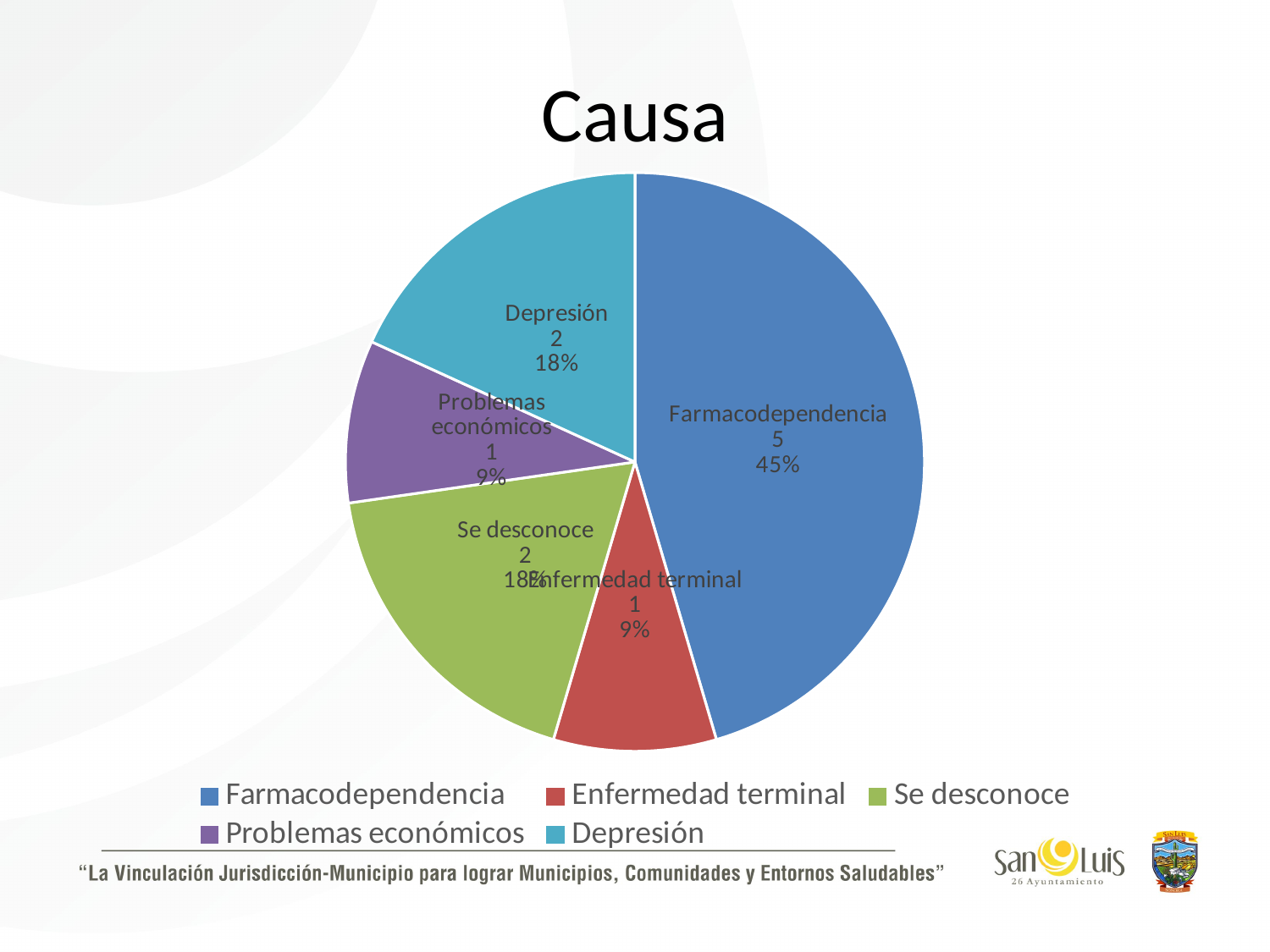
How many slices does the pie chart have? 5 What kind of chart is shown on the slide? pie chart Which category has the largest slice? Farmacodependencia What colour is the Problemas económicos slice? purple What is the title of the chart? Causa What is the difference between the values for Farmacodependencia and Depresión? 3 How many entries does the legend list? 5 Which is larger, the value for Se desconoce or the value for Enfermedad terminal? Se desconoce What is the value for Farmacodependencia? 5 What percentage share does Se desconoce have? 18% What percentage share does Farmacodependencia have? 45% What is the value for Depresión? 2